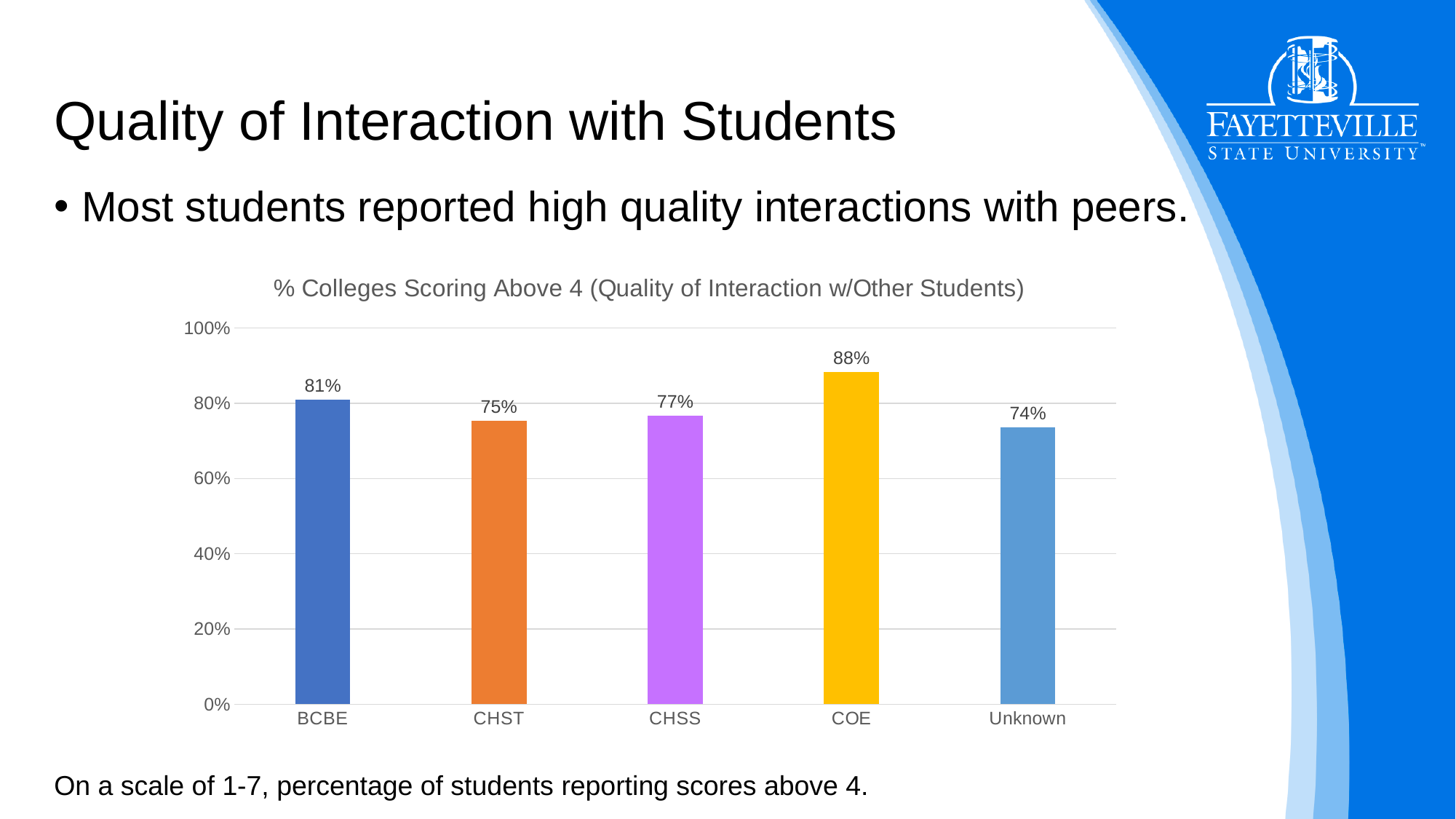
What is the value for COE? 88% Which category has the lowest value? Unknown What is the value for BCBE? 81% What kind of chart is shown on the slide? bar chart What is the value for Unknown? 74% What is the difference between the values for COE and CHST? 13% How many categories are shown on the x axis? 5 Is the value for CHST greater or less than 80%? less What is the difference between the values for BCBE and Unknown? 7% Which category has the highest value? COE Which is larger, the value for CHSS or the value for CHST? CHSS What is the title of the chart? % Colleges Scoring Above 4 (Quality of Interaction w/Other Students)